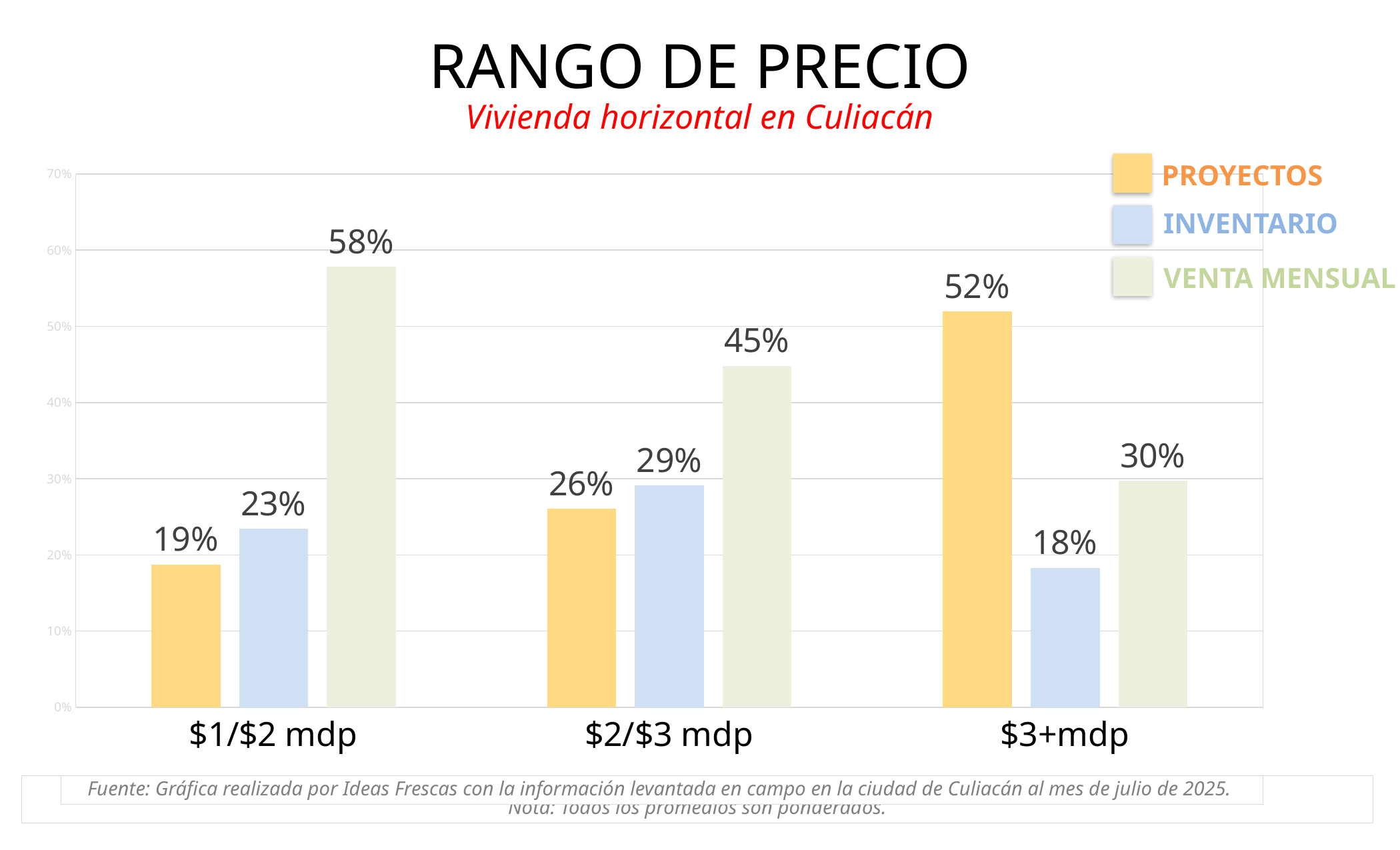
What is the PROYECTOS value for the $3+mdp price range? 52% How many series does the legend list? 3 What is the subtitle shown in red below the chart title? Vivienda horizontal en Culiacán Which price range has the lowest INVENTARIO value? $3+mdp What is the VENTA MENSUAL value for the $1/$2 mdp price range? 58% What kind of chart is shown on the slide? Bar chart How many price range categories are shown on the x axis? 3 Which price range has the highest VENTA MENSUAL value? $1/$2 mdp Which is larger for the $3+mdp price range: PROYECTOS or VENTA MENSUAL? PROYECTOS Do the PROYECTOS values rise or fall from $1/$2 mdp to $3+mdp? Rise What is the difference between the VENTA MENSUAL and PROYECTOS values for the $1/$2 mdp price range? 39% What is the INVENTARIO value for the $2/$3 mdp price range? 29%